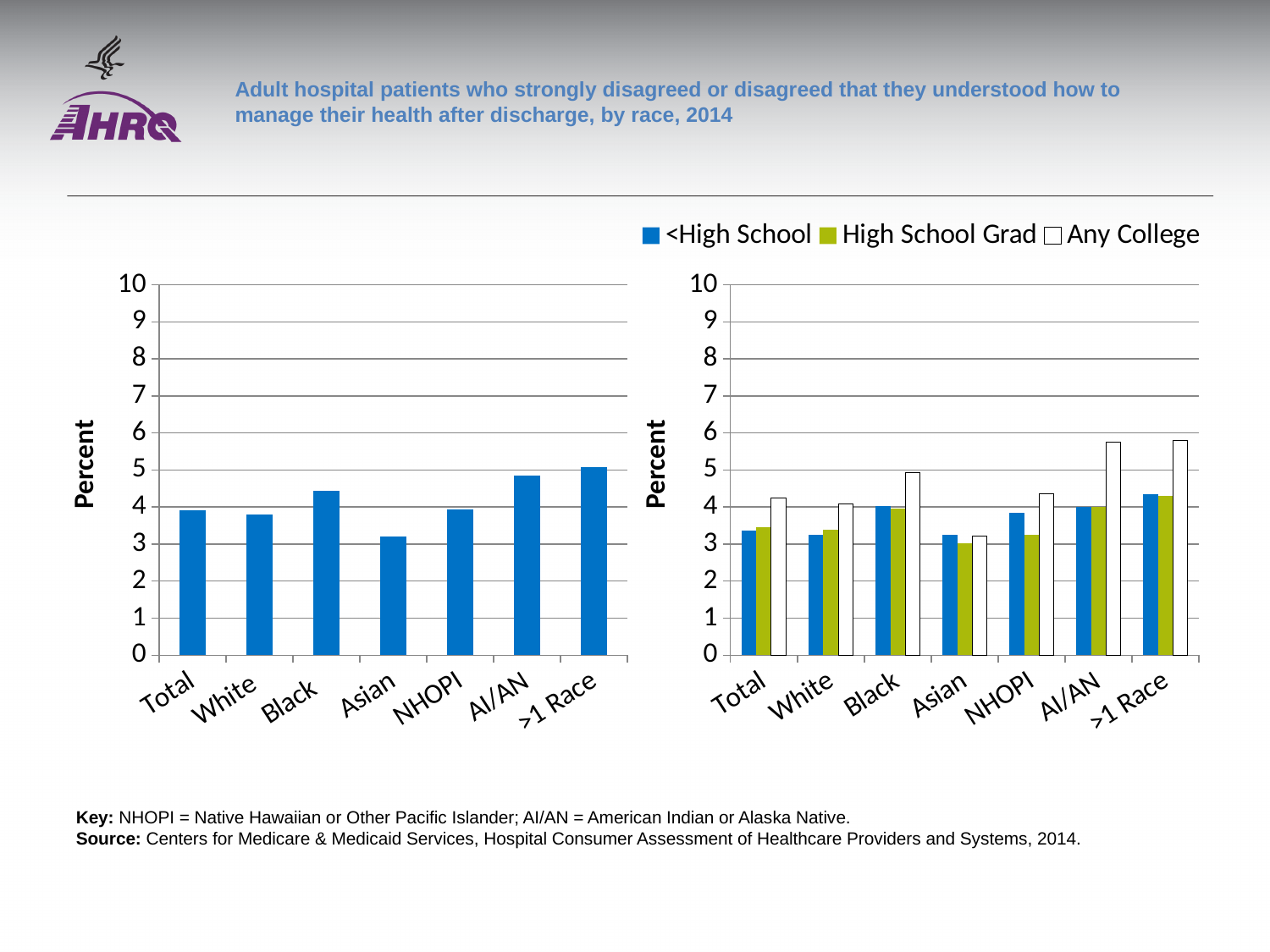
In the left chart, is the value for Asian greater or less than 4? less How many series does the legend of the right chart list? 3 What kind of chart is the left chart on the slide? bar chart In the right chart, is the Any College value for Black greater or less than 4? greater In the left chart, which race category has the highest value? >1 Race In the right chart, for Black, which is larger, the Any College value or the <High School value? Any College What is the label on the vertical axis of the right chart? Percent How many race categories are shown on the x axis of the left chart? 7 In the left chart, which race category has the lowest value? Asian In the left chart, which is larger, the value for Black or the value for White? Black What are the three series named in the legend of the right chart? <High School, High School Grad, Any College